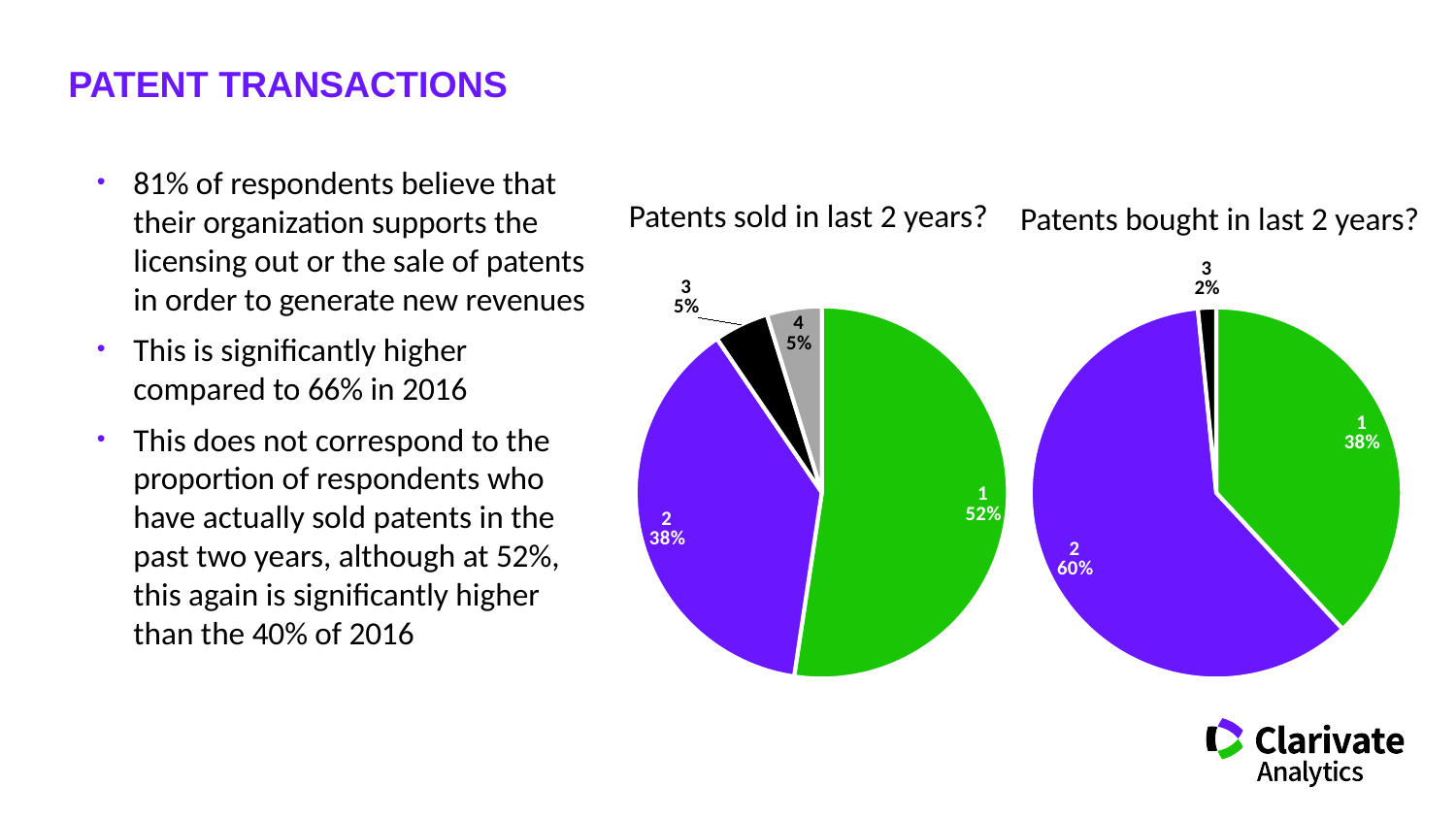
In the 'Patents bought in last 2 years?' chart, which slice has the smallest share? 3 In the 'Patents sold in last 2 years?' chart, what percentage is shown for slice 1? 52% In the 'Patents bought in last 2 years?' chart, what percentage is shown for slice 3? 2% How many slices does the 'Patents bought in last 2 years?' chart have? 3 In the 'Patents sold in last 2 years?' chart, what percentage is shown for slice 2? 38% How many slices does the 'Patents sold in last 2 years?' chart have? 4 In the 'Patents sold in last 2 years?' chart, what is the difference in percentage points between slice 1 and slice 2? 14 In the 'Patents bought in last 2 years?' chart, what percentage is shown for slice 2? 60% What type of chart is used for 'Patents bought in last 2 years?'? Pie chart Is slice 1 larger in the 'Patents sold in last 2 years?' chart or in the 'Patents bought in last 2 years?' chart? Patents sold in last 2 years? In the 'Patents sold in last 2 years?' chart, which slice has the largest share? 1 In the 'Patents bought in last 2 years?' chart, what is the difference in percentage points between slice 2 and slice 1? 22